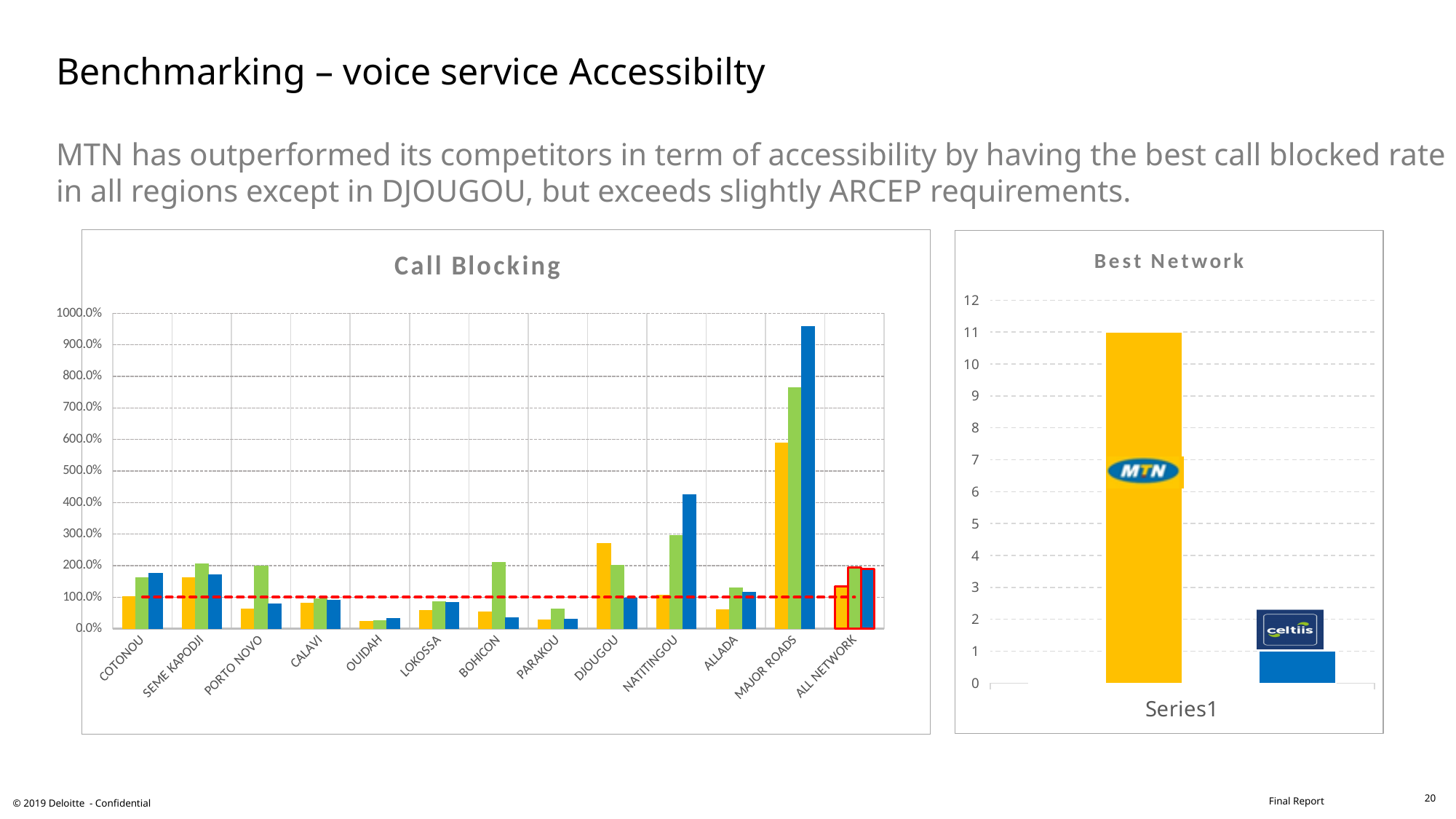
In the Call Blocking chart, is the tallest bar for NATITINGOU greater or less than 300.0%? greater In the Call Blocking chart, is the tallest bar for MAJOR ROADS greater or less than 900.0%? greater What kind of chart is the Call Blocking chart? bar chart In the Call Blocking chart, are the bars for OUIDAH greater or less than 100.0%? less In the Best Network chart, what value does the Celtiis bar reach? 1 What kind of chart is the Best Network chart? bar chart In the Best Network chart, what is the difference between the MTN bar and the Celtiis bar? 10 In the Best Network chart, what value does the MTN bar reach? 11 In the Call Blocking chart, which category has the tallest bar? MAJOR ROADS How many categories are shown on the x axis of the Call Blocking chart? 13 What is the category label shown on the x axis of the Best Network chart? Series1 In the Call Blocking chart, which category has a taller tallest bar, MAJOR ROADS or ALL NETWORK? MAJOR ROADS